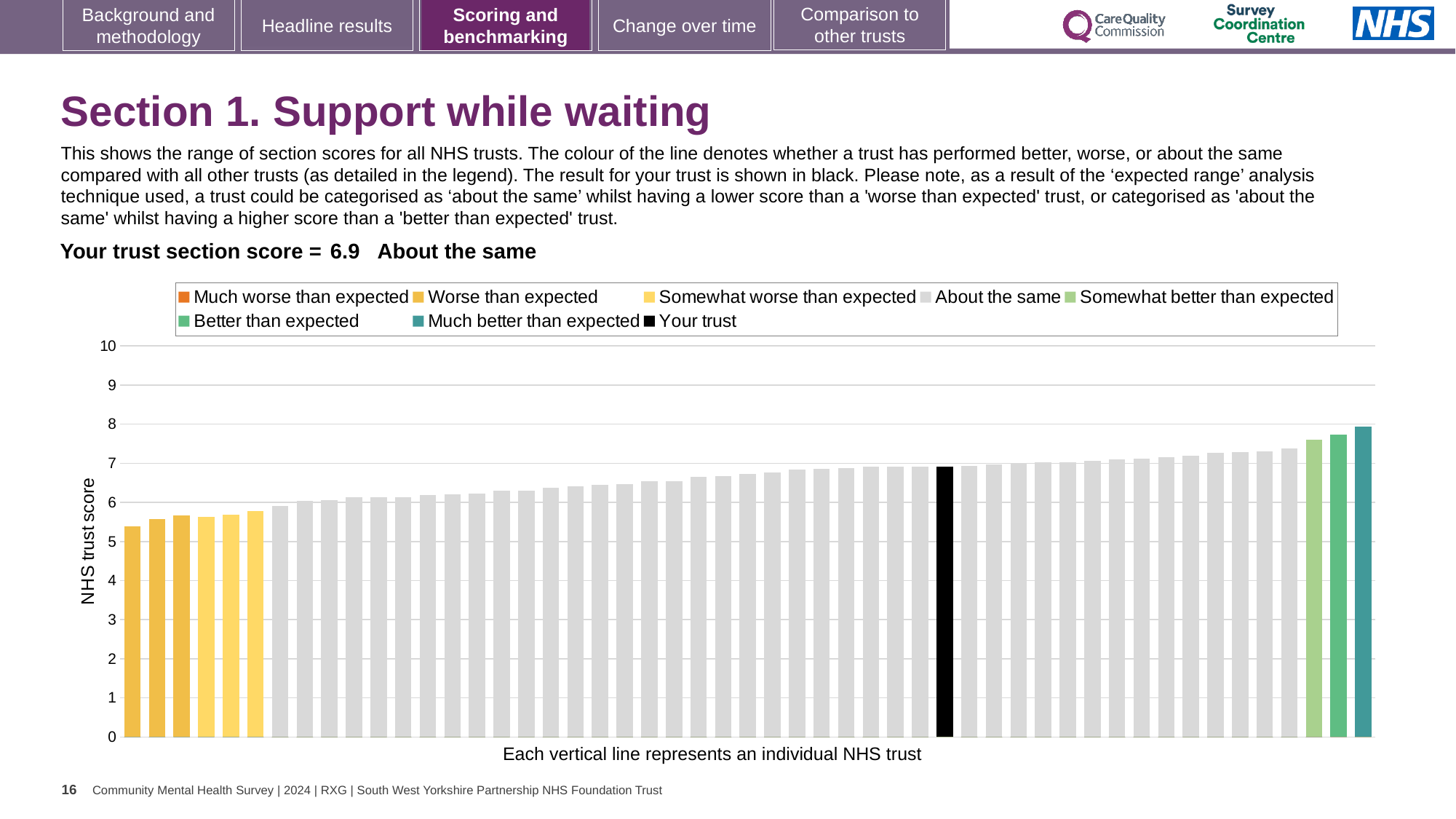
What colour is the bar representing your trust? black Is the value of the leftmost (lowest) bar greater or less than 6? less How many entries does the chart legend list? 8 Is the value of the black 'Your trust' bar greater or less than 6? greater What kind of chart is shown on the slide? bar chart Which is larger: the black 'Your trust' bar or the leftmost yellow bar? the black 'Your trust' bar Do the bar values rise or fall from left to right along the x axis? rise What is the label on the vertical axis? NHS trust score Which category is your trust placed in for this section? About the same What is the section score for your trust shown on the slide? 6.9